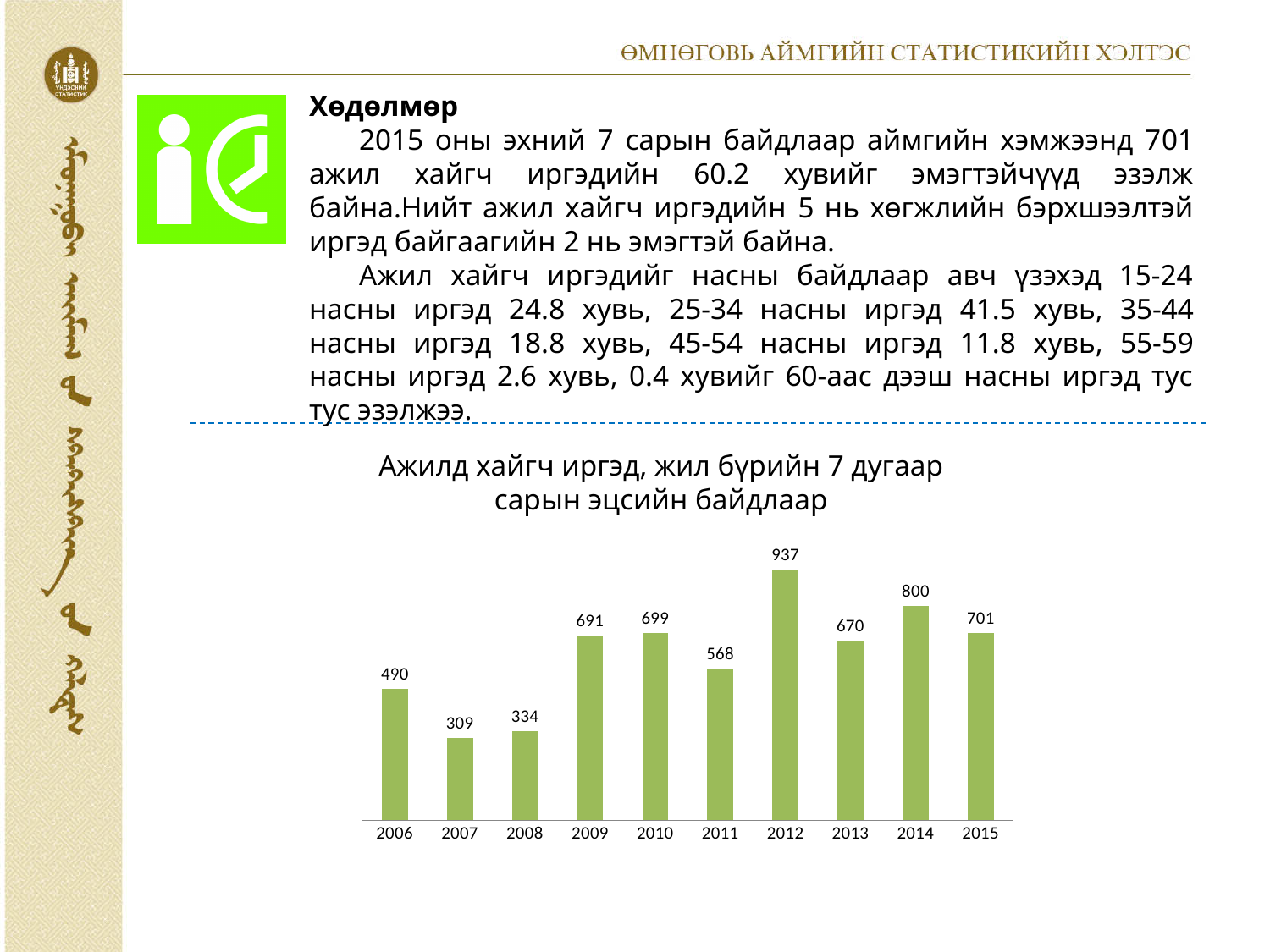
What is the value for 2007? 309 Which year has the highest value? 2012 What is the value for 2012? 937 Which is larger, the value for 2009 or the value for 2013? 2009 What is the difference between the values for 2014 and 2015? 99 What kind of chart is this? bar chart What is the value for 2015? 701 How many years are shown on the x axis? 10 What is the title of the chart? Ажилд хайгч иргэд, жил бүрийн 7 дугаар сарын эцсийн байдлаар Do the values rise or fall from 2007 to 2012? rise Which year has the lowest value? 2007 What is the difference between the values for 2012 and 2011? 369